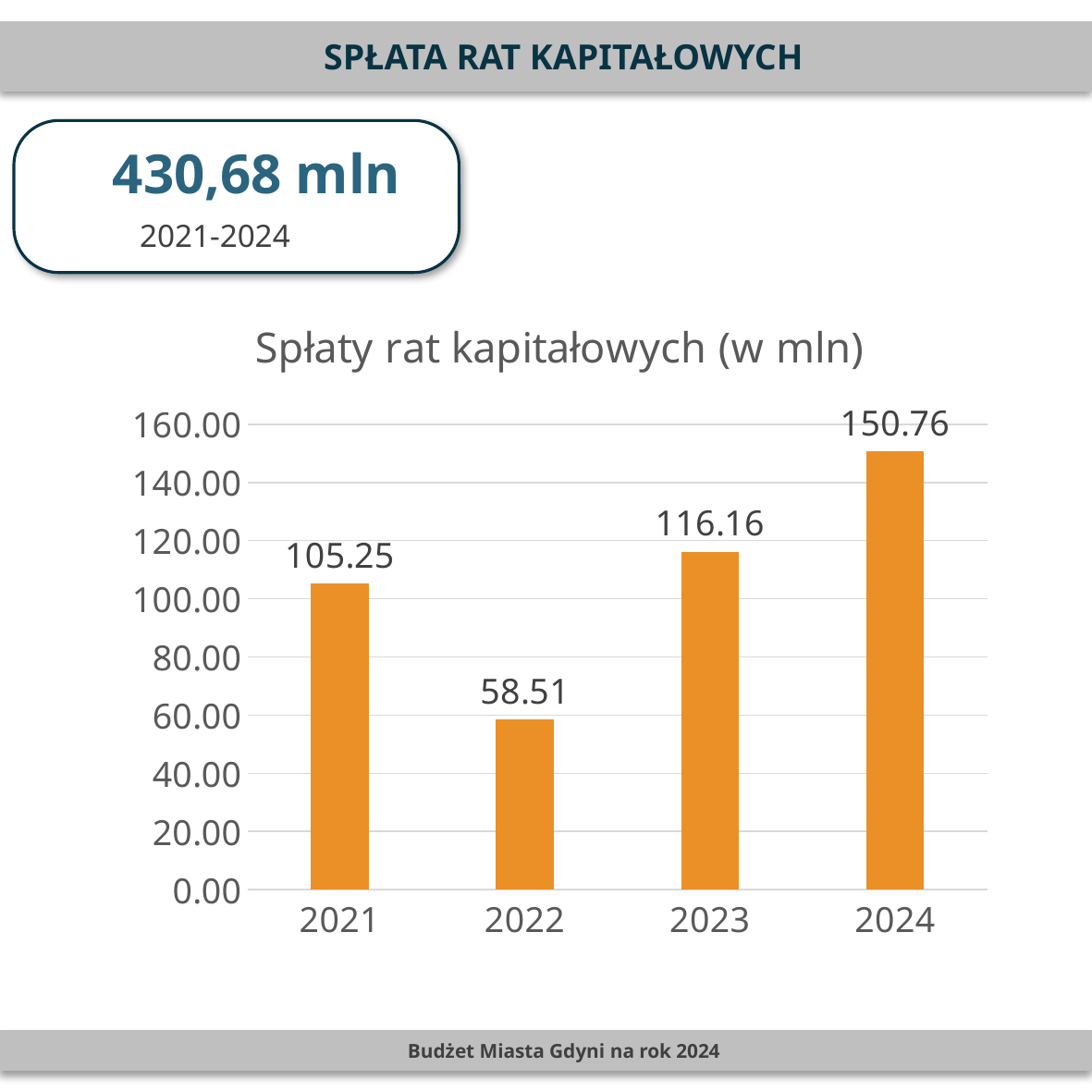
How many years are shown on the x axis of the chart? 4 Which is larger, the value for 2023 or the value for 2021? 2023 What is the title of the chart? Spłaty rat kapitałowych (w mln) What is the value for 2021 in the chart? 105.25 Is the value for 2022 greater or less than 60.00? less What is the value for 2024 in the chart? 150.76 Which year has the highest value in the chart? 2024 What is the value for 2022 in the chart? 58.51 Which year has the lowest value in the chart? 2022 What kind of chart is shown on the slide? bar chart What is the difference between the values for 2023 and 2021? 10.91 What is the difference between the values for 2024 and 2022? 92.25